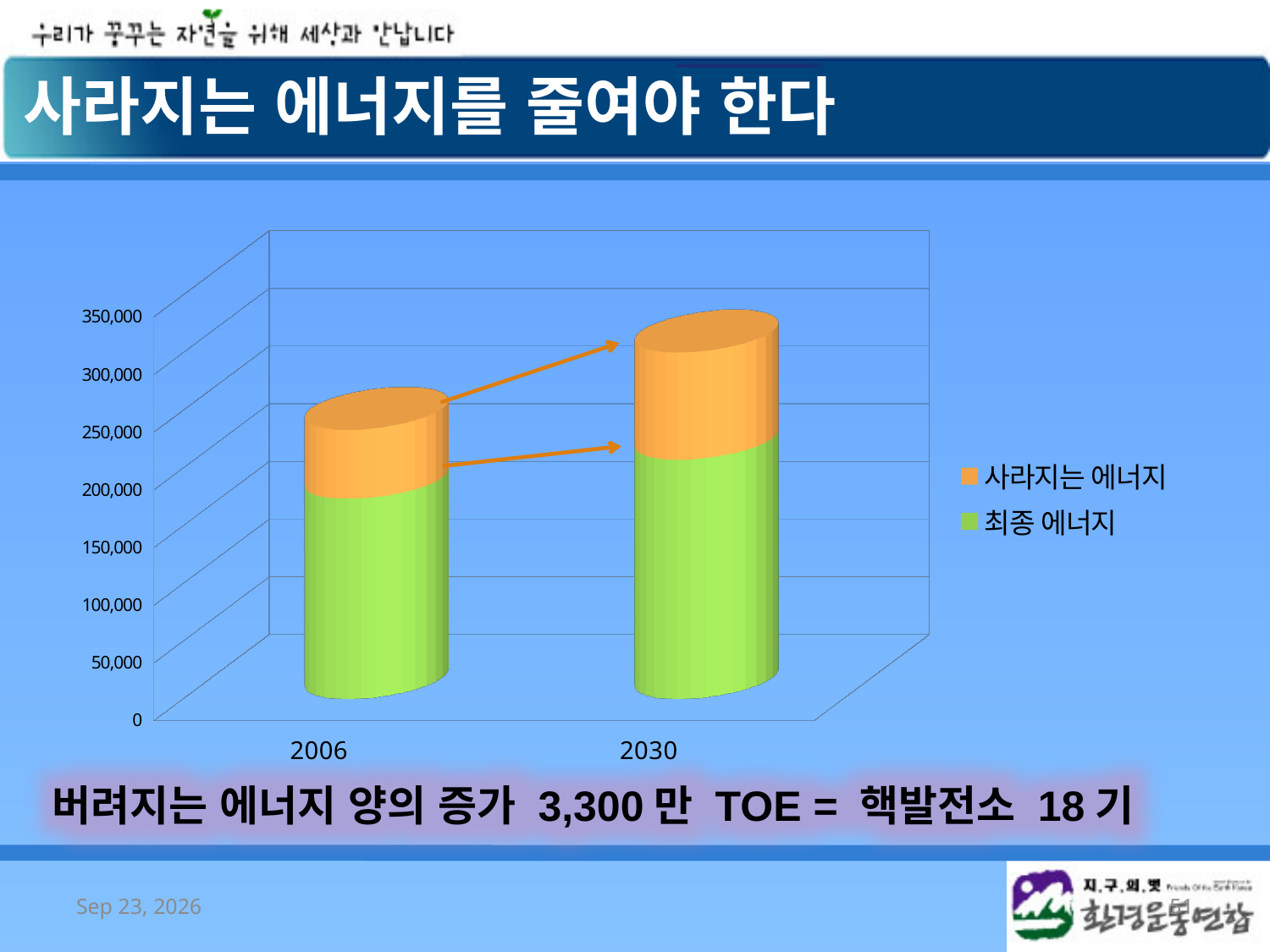
Does the total stacked value rise or fall from 2006 to 2030? Rise Which year has the taller stacked bar, 2006 or 2030? 2030 Is the 최종 에너지 value for 2030 larger or smaller than the 최종 에너지 value for 2006? Larger Is the 최종 에너지 value for 2030 greater or less than 250,000? less Is the total stacked value for 2006 greater or less than 200,000? greater What are the two series listed in the chart legend? 사라지는 에너지, 최종 에너지 What kind of chart is shown on the slide? Stacked bar chart How many categories are shown on the x axis of the chart? 2 How many series does the chart legend list? 2 Is the 사라지는 에너지 segment larger in 2006 or in 2030? 2030 Which series is shown in orange in the chart? 사라지는 에너지